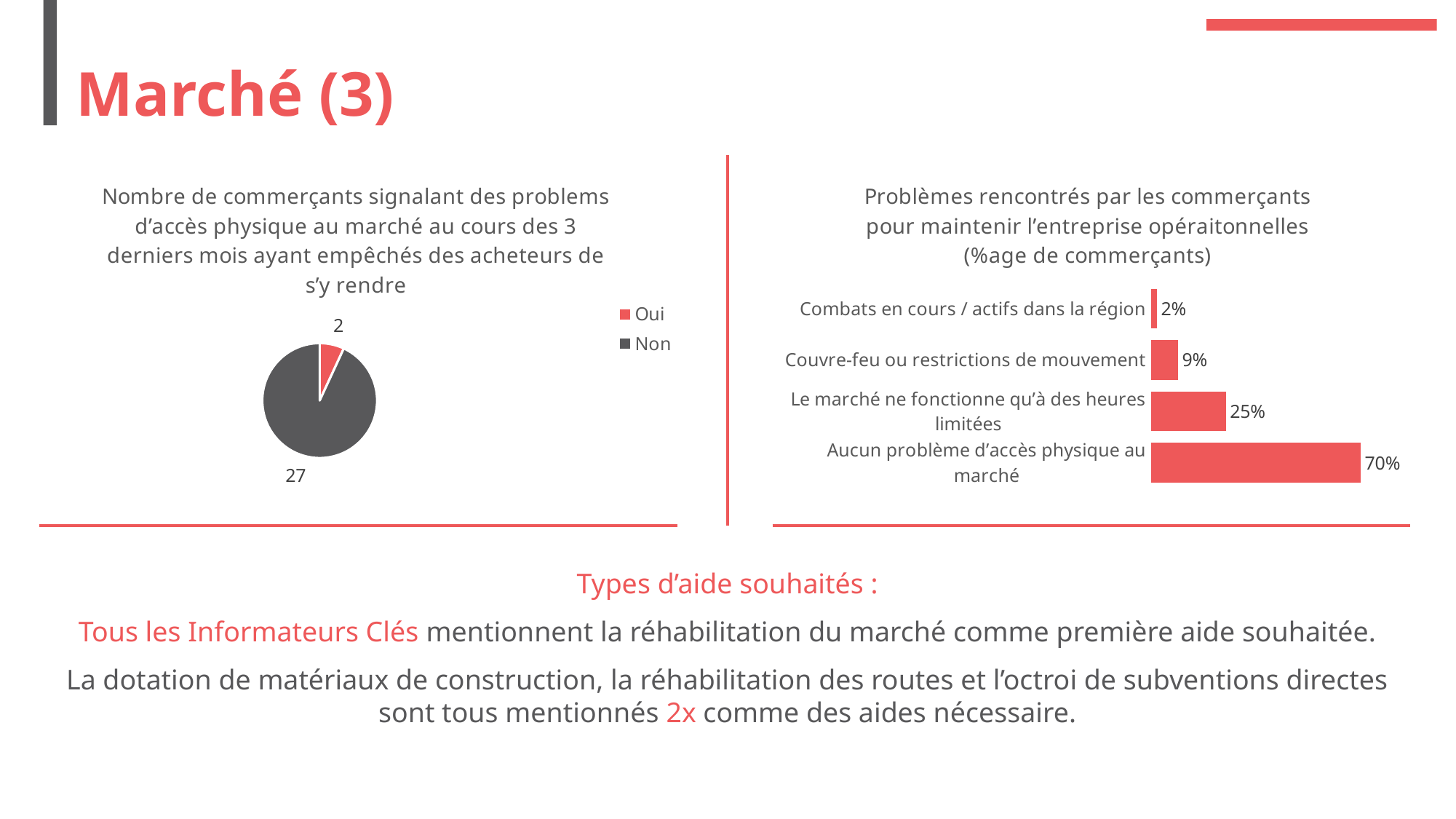
In the pie chart on the left, what is the difference between the Non and Oui counts? 25 In the chart titled "Problèmes rencontrés par les commerçants", what is the value for "Le marché ne fonctionne qu'à des heures limitées"? 25% In the pie chart on the left, how many entries does the legend list? 2 In the pie chart on the left, how many merchants answered "Oui"? 2 In the pie chart on the left, how many merchants answered "Non"? 27 In the pie chart on the left, which category has the larger slice, Oui or Non? Non What type of chart is shown on the left side of the slide? Pie chart In the chart titled "Problèmes rencontrés par les commerçants", which category has the lowest value? Combats en cours / actifs dans la région In the chart titled "Problèmes rencontrés par les commerçants", how many categories are shown? 4 In the chart titled "Problèmes rencontrés par les commerçants", what is the difference between "Aucun problème d'accès physique au marché" and "Le marché ne fonctionne qu'à des heures limitées"? 45% In the chart titled "Problèmes rencontrés par les commerçants", what is the value for "Couvre-feu ou restrictions de mouvement"? 9% In the chart titled "Problèmes rencontrés par les commerçants", which category has the highest value? Aucun problème d'accès physique au marché